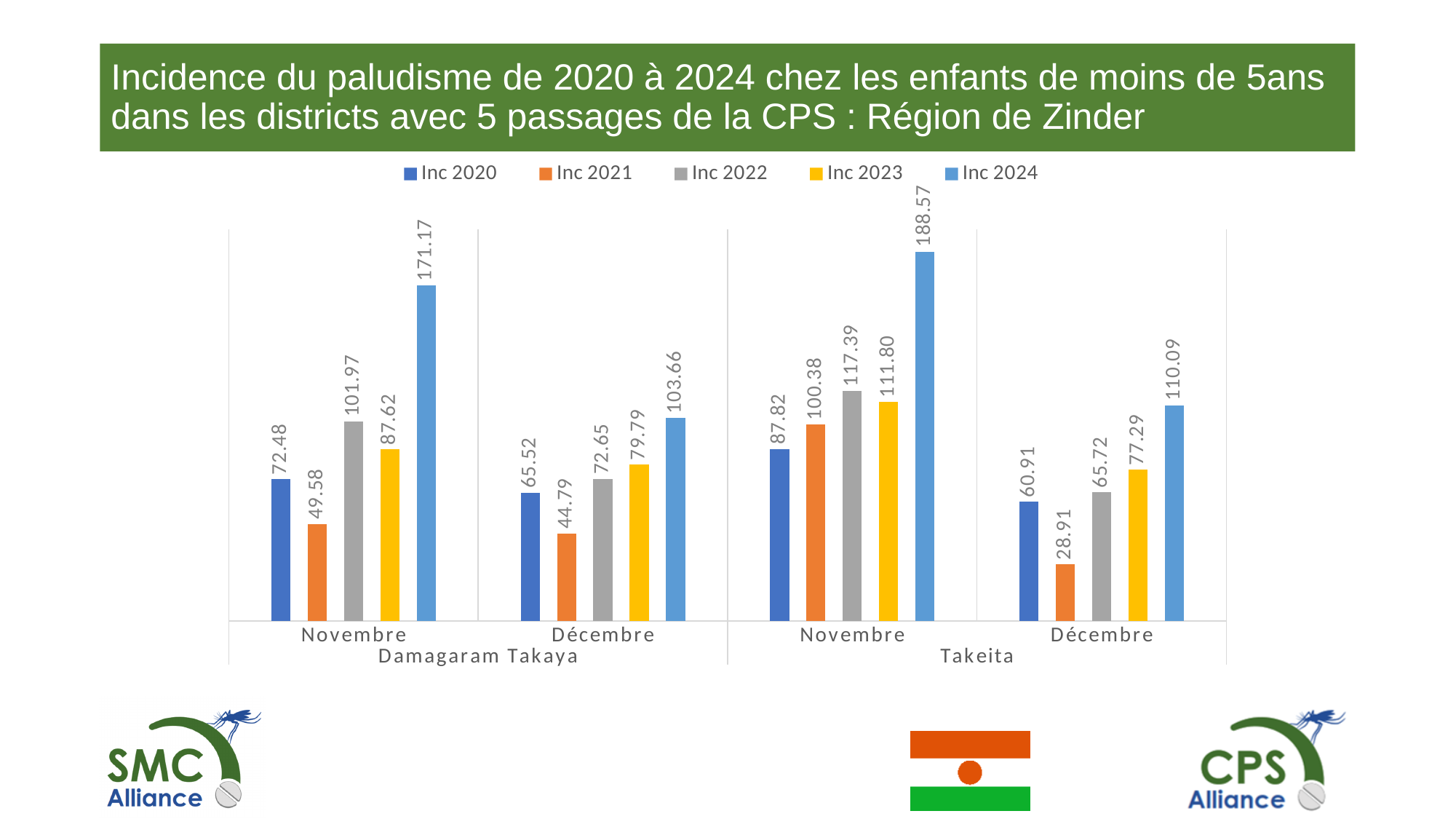
What is the Inc 2024 value for Novembre in Takeita? 188.57 Which series has the lowest value for Décembre in Takeita? Inc 2021 How many series does the legend list? 5 What is the Inc 2022 value for Novembre in Damagaram Takaya? 101.97 Which series has the highest value for Novembre in Damagaram Takaya? Inc 2024 What is the difference between the Inc 2024 and Inc 2020 values for Novembre in Takeita? 100.75 How many month categories are shown on the x axis? 4 What kind of chart is shown on the slide? Bar chart Which colour represents Inc 2021 in the legend? Orange What is the Inc 2023 value for Décembre in Takeita? 77.29 What is the Inc 2021 value for Décembre in Damagaram Takaya? 44.79 Which is larger for Décembre in Damagaram Takaya: Inc 2022 or Inc 2023? Inc 2023